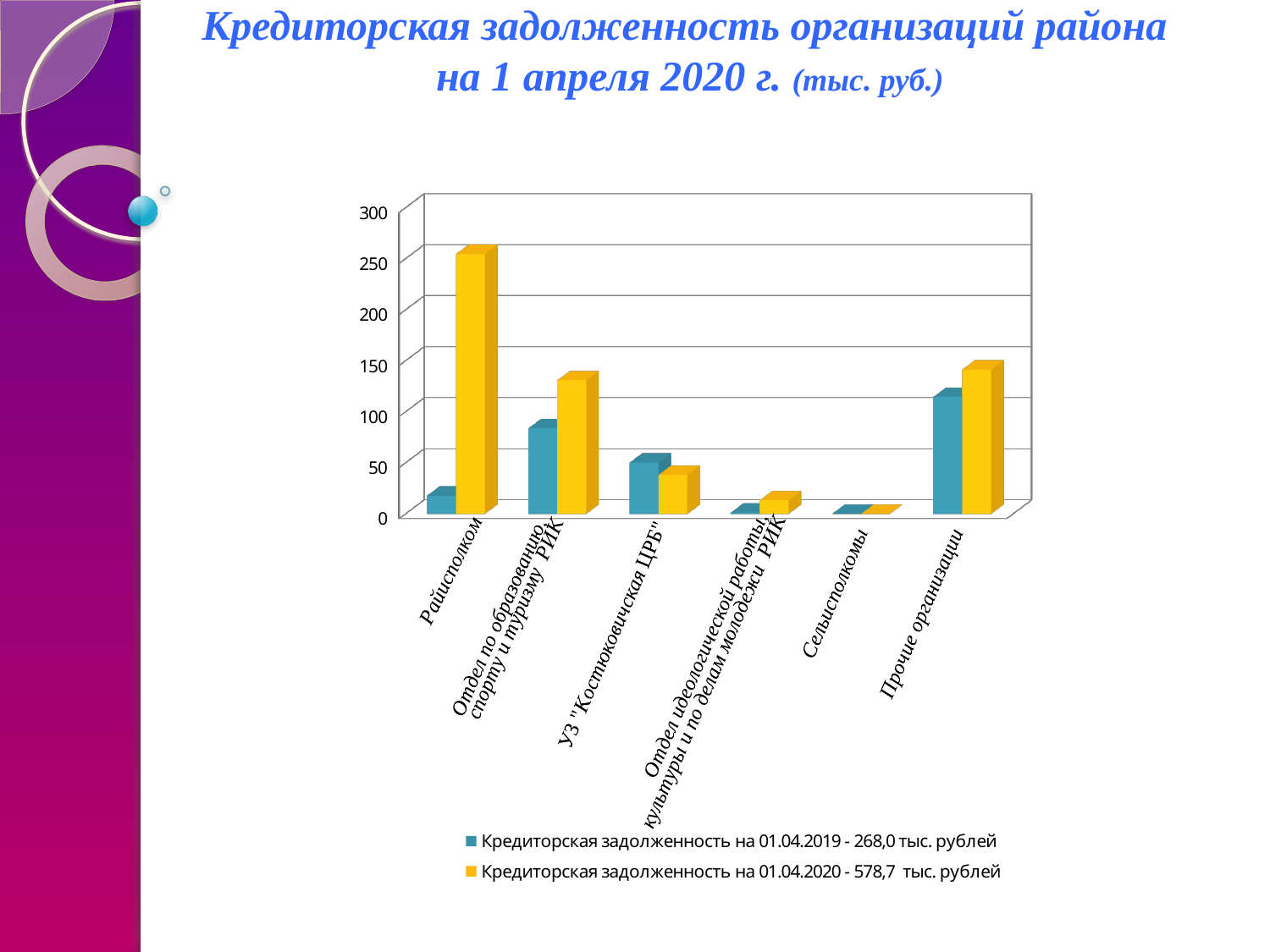
Which category has the highest value for the series 'Кредиторская задолженность на 01.04.2019'? Прочие организации According to the legend, what is the total creditor debt as of 01.04.2020? 578,7 тыс. рублей For Райисполком, which series has the larger value: 01.04.2019 or 01.04.2020? 01.04.2020 What kind of chart is shown on the slide? bar chart Is the value for Райисполком in the 01.04.2019 series greater or less than 50? less Which category has the highest value for the series 'Кредиторская задолженность на 01.04.2020'? Райисполком Is the value for Отдел по образованию, спорту и туризму РИК in the 01.04.2020 series greater or less than 100? greater Is the value for Прочие организации in the 01.04.2019 series greater or less than 100? greater How many series does the legend list? 2 How many categories are shown on the x axis of the chart? 6 For УЗ "Костюковичская ЦРБ", which series has the larger value: 01.04.2019 or 01.04.2020? 01.04.2019